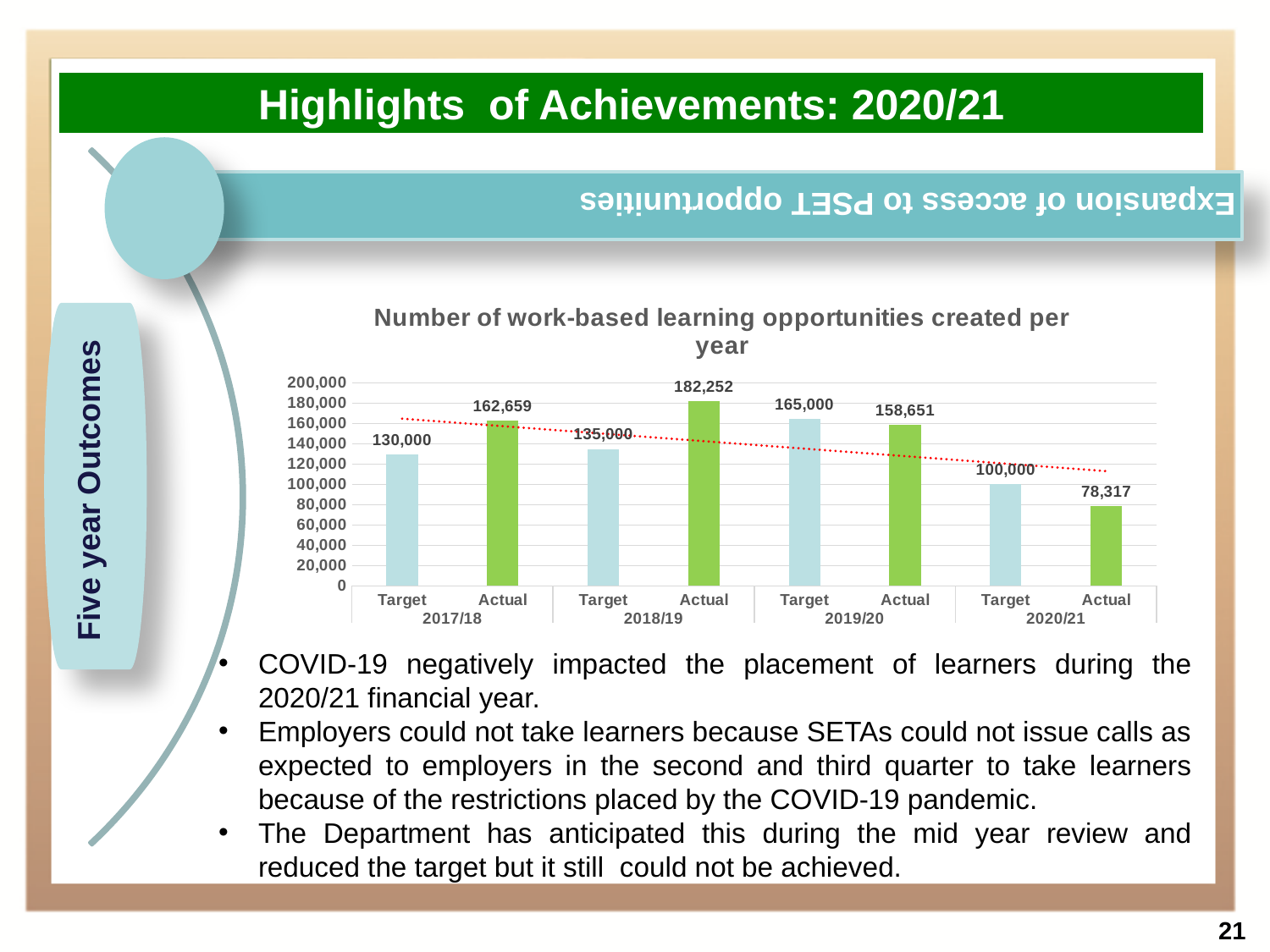
What was the target for work-based learning opportunities in 2019/20? 165,000 What was the actual number of work-based learning opportunities created in 2018/19? 182,252 Which is larger for 2019/20, the target or the actual value? Target What is the difference between the target and actual values for 2020/21? 21,683 What was the actual number of work-based learning opportunities created in 2020/21? 78,317 Is the actual value for 2017/18 greater or less than 140,000? greater How many bars are plotted in the chart? 8 What is the title of the chart? Number of work-based learning opportunities created per year Which bar has the highest value in the chart? Actual 2018/19 Which bar has the lowest value in the chart? Actual 2020/21 Do the actual values rise or fall from 2018/19 to 2020/21? fall What type of chart is shown on the slide? bar chart